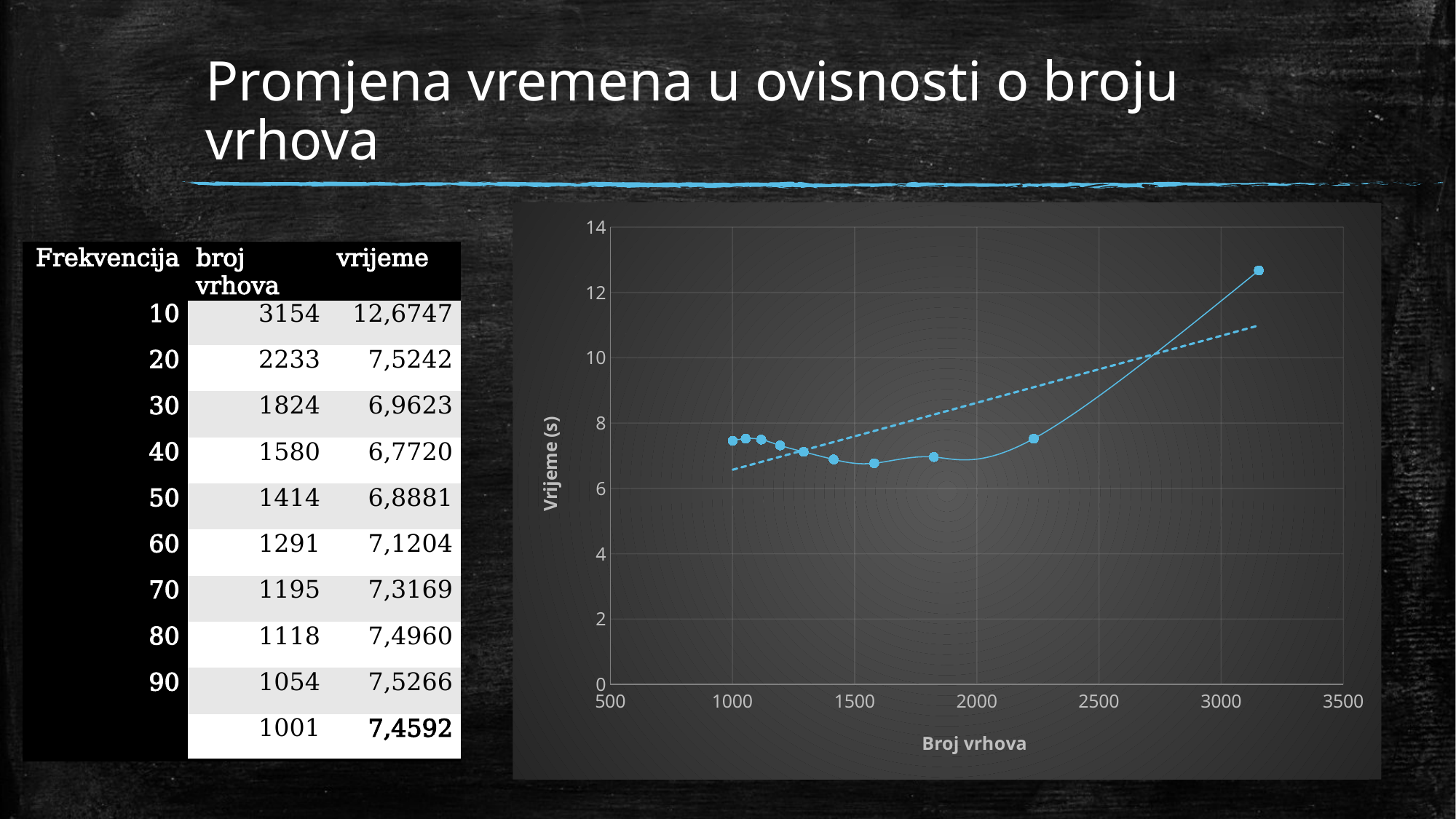
What is the title of the chart's x axis? Broj vrhova According to the table on the slide, what is the time (vrijeme) for 2233 vertices? 7,5242 What is the title of the chart's y axis? Vrijeme (s) Does the plotted time rise or fall as the number of vertices increases from 2233 to 3154? rise How many data points are plotted on the chart? 10 Using the table values, what is the difference between the time for 3154 vertices and the time for 1001 vertices? 5,2155 Which number of vertices (broj vrhova) has the highest time value on the chart? 3154 Which has the larger time value on the chart: the point at 3154 vertices or the point at 2233 vertices? 3154 What kind of chart is shown on the slide? scatter chart with smoothed lines Is the time value for the point at 1580 vertices greater or less than 8? less According to the table on the slide, what is the time (vrijeme) for 1001 vertices? 7,4592 Is the time value for the point at 3154 vertices greater or less than 12? greater